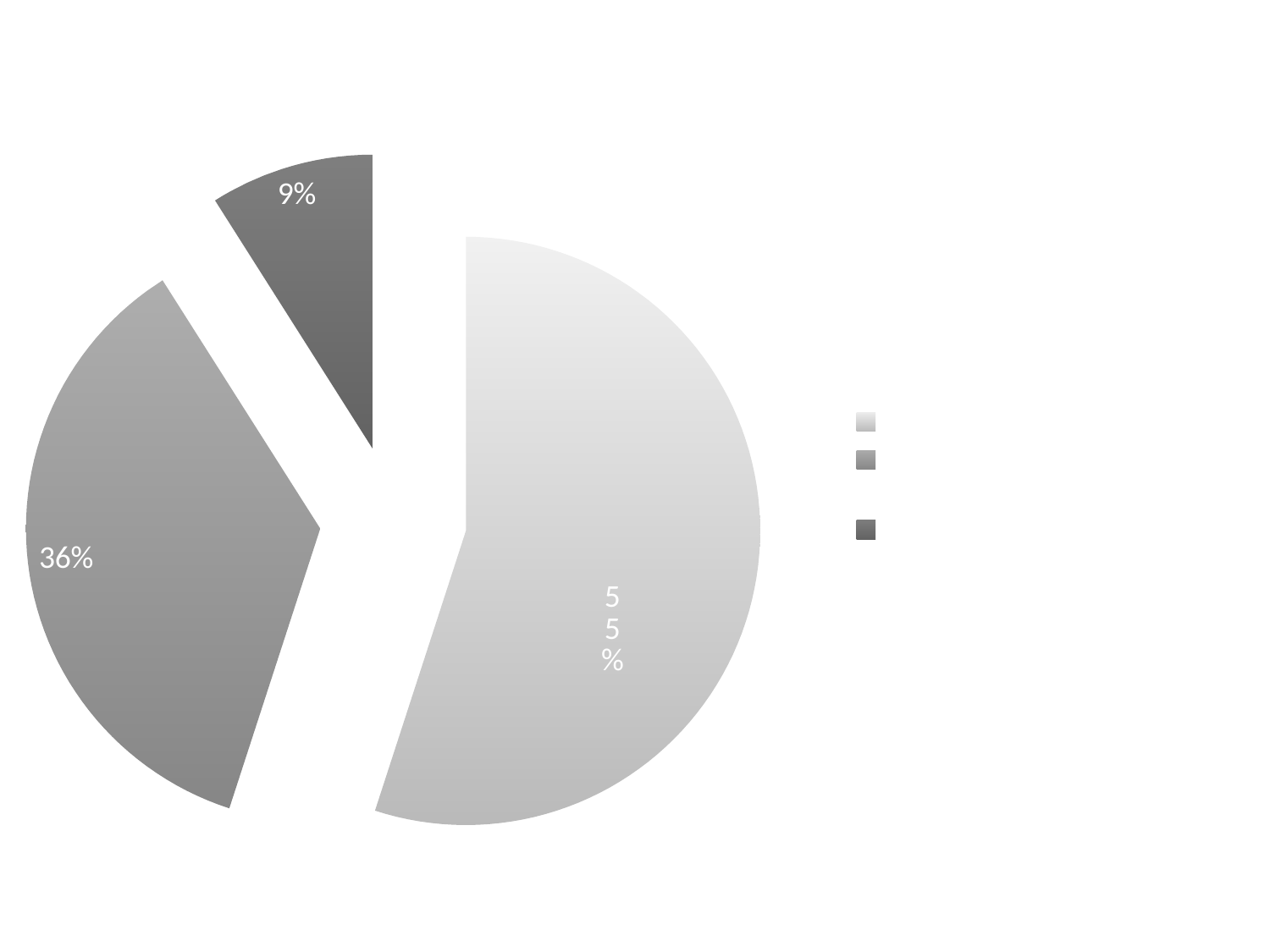
Which slice of the pie chart is the smallest? the darkest grey slice (9%) What is the difference in percentage points between the 55% slice and the 36% slice? 19 Which is larger, the medium grey slice or the darkest grey slice? the medium grey slice What kind of chart is shown on the slide? pie chart What share of the pie does the lightest grey slice represent? 55% What share of the pie does the medium grey slice represent? 36% Which slice of the pie chart is the largest? the lightest grey slice (55%) Is the share of the largest slice greater or less than 50%? greater How many slices does the pie chart have? 3 What share of the pie does the darkest grey slice represent? 9% How many entries does the legend of the pie chart list? 3 What is the difference in percentage points between the largest slice and the smallest slice? 46